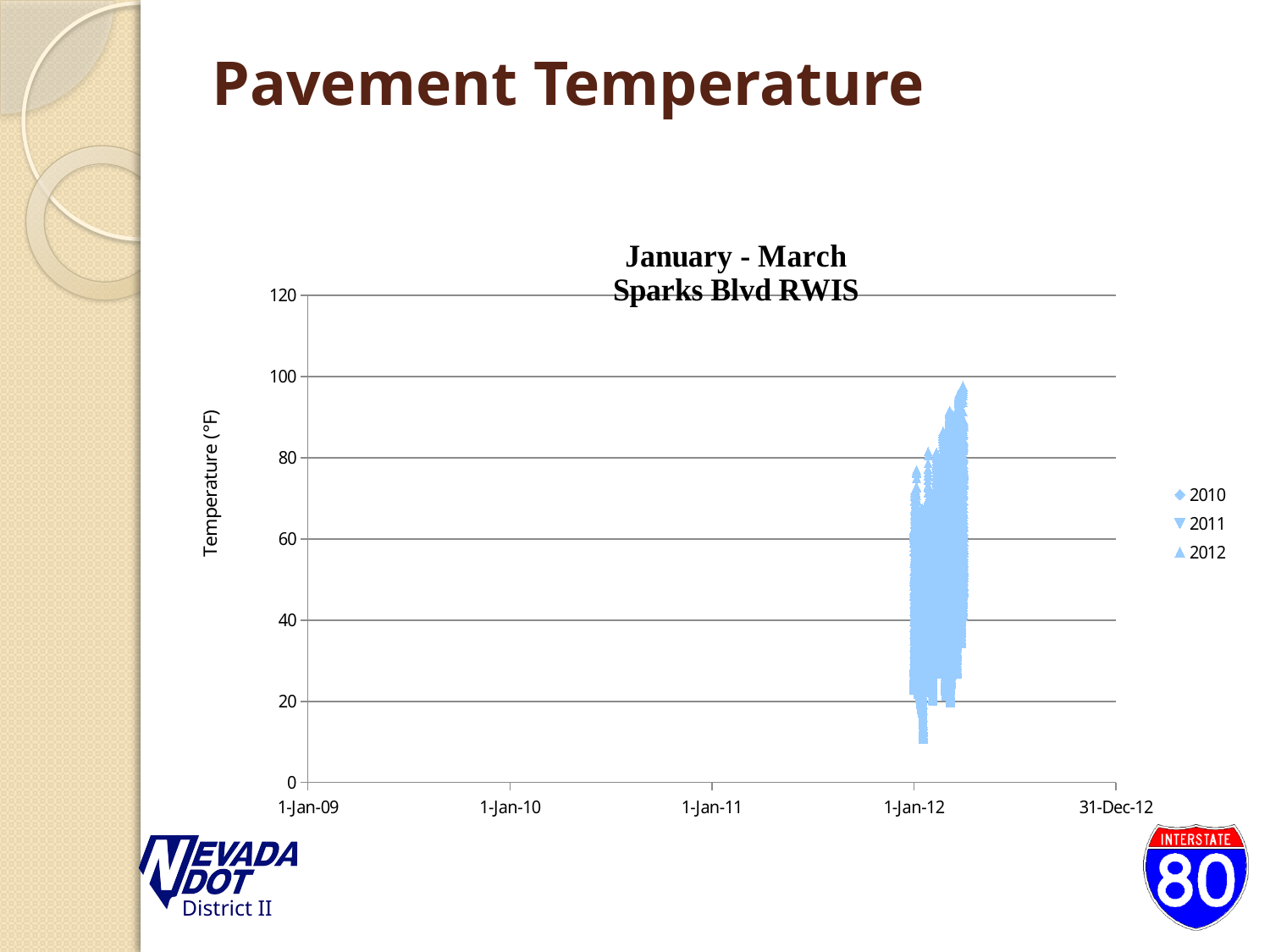
What are the series names listed in the legend? 2010, 2011, 2012 Is the highest plotted temperature greater or less than 100? less Is the highest plotted temperature greater or less than 80? greater What is the last date label on the horizontal axis? 31-Dec-12 Is the lowest plotted temperature greater or less than 20? less How many series does the legend list? 3 What is the maximum value shown on the vertical axis? 120 What is the title of the chart? January - March Sparks Blvd RWIS What is the label on the vertical axis? Temperature (°F) Near which x-axis date label do the plotted points appear? 1-Jan-12 What is the first date label on the horizontal axis? 1-Jan-09 What kind of chart is shown on the slide? Scatter chart